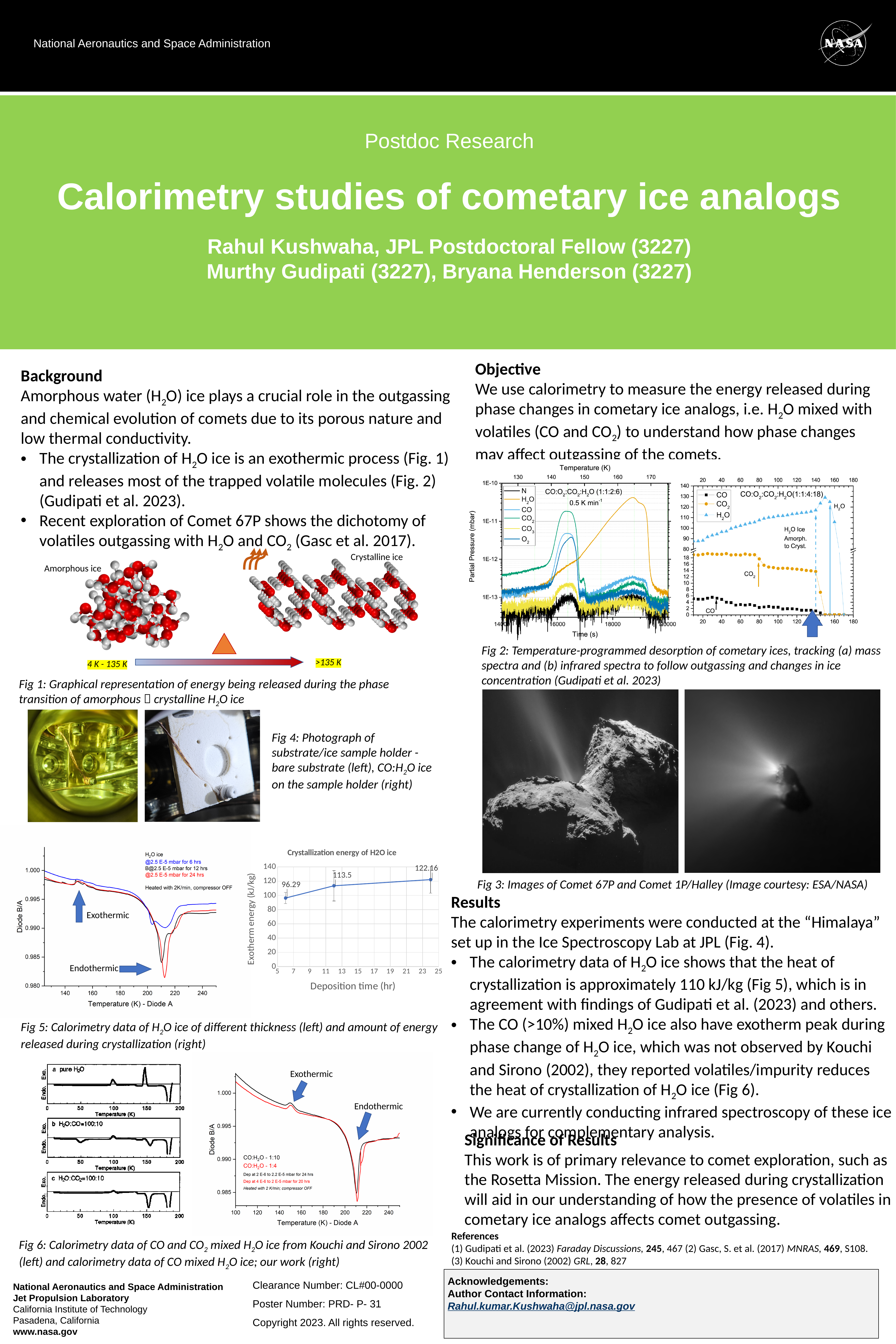
What kind of chart is the 'Crystallization energy of H2O ice' chart? Line chart In the 'Crystallization energy of H2O ice' chart, which is larger: the value at the shortest deposition time or the value at the longest deposition time? The value at the longest deposition time (122.16) In the 'Crystallization energy of H2O ice' chart, what is the difference between the highest and lowest labelled values? 25.87 In the 'Crystallization energy of H2O ice' chart, what is the difference between the labelled values 113.5 and 96.29? 17.21 In the 'Crystallization energy of H2O ice' chart, what is the exotherm energy value labelled for the middle data point? 113.5 What is the x-axis title of the 'Crystallization energy of H2O ice' chart? Deposition time (hr) In the 'Crystallization energy of H2O ice' chart, what is the highest exotherm energy value labelled? 122.16 In the 'Crystallization energy of H2O ice' chart, does the exotherm energy rise or fall as deposition time increases? Rises In the 'Crystallization energy of H2O ice' chart, how many data points are plotted? 3 How many series does the legend of the left-hand chart in Fig 2 (CO:O2:CO2:H2O 1:1:2:6) list? 6 In the 'Crystallization energy of H2O ice' chart, what is the lowest exotherm energy value labelled? 96.29 How many series does the legend of the right-hand chart in Fig 2 (CO:O2:CO2:H2O 1:1:4:18) list? 3